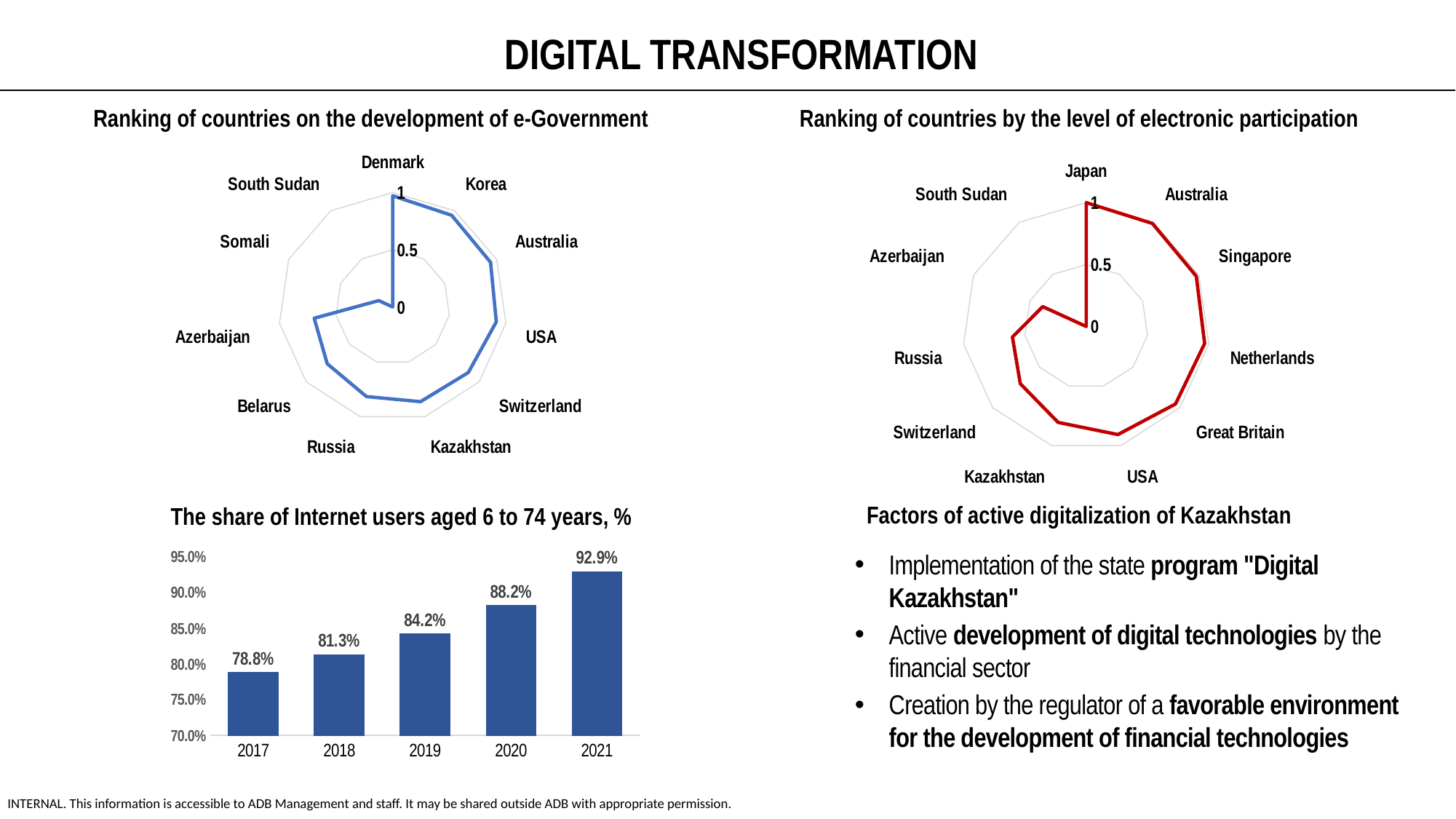
On the chart 'Ranking of countries by the level of electronic participation', is the value for Azerbaijan greater or less than 0.5? less On the chart 'The share of Internet users aged 6 to 74 years, %', do the values rise or fall from 2017 to 2021? rise On the chart 'The share of Internet users aged 6 to 74 years, %', which year has the lowest value? 2017 On the chart 'The share of Internet users aged 6 to 74 years, %', how many years are shown? 5 What kind of chart is 'The share of Internet users aged 6 to 74 years, %'? bar chart On the chart 'The share of Internet users aged 6 to 74 years, %', what is the value for 2021? 92.9% What kind of chart is 'Ranking of countries on the development of e-Government'? radar chart On the chart 'Ranking of countries on the development of e-Government', is the value for Somali greater or less than 0.5? less On the chart 'The share of Internet users aged 6 to 74 years, %', what is the difference between the 2021 and 2017 values? 14.1% On the chart 'Ranking of countries on the development of e-Government', how many countries are shown? 11 On the chart 'Ranking of countries by the level of electronic participation', is the value for Kazakhstan greater or less than 0.5? greater On the chart 'The share of Internet users aged 6 to 74 years, %', what is the value for 2019? 84.2%